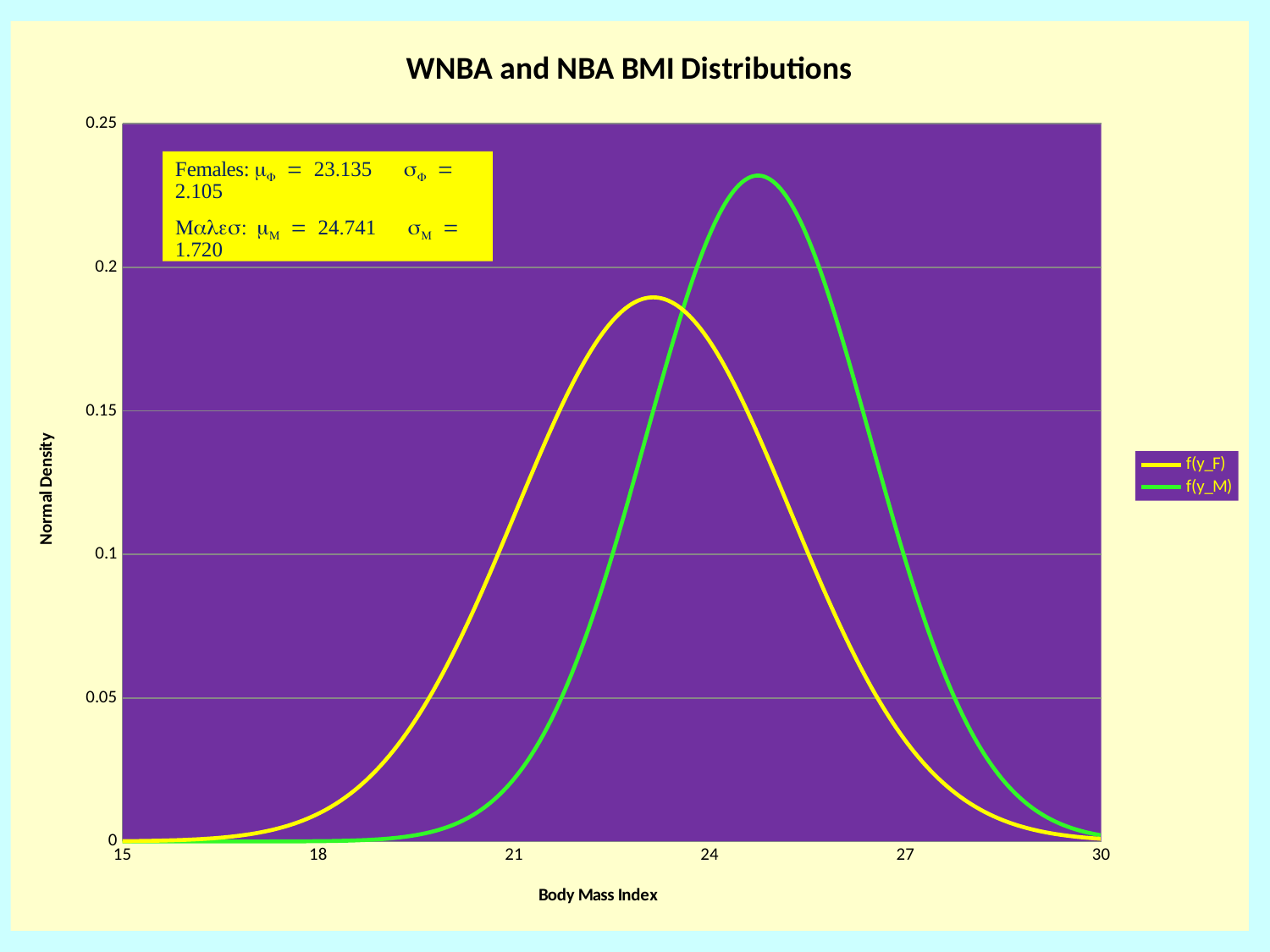
Does the f(y_F) curve rise or fall as Body Mass Index increases from 18 to 21? rise What are the two series named in the legend? f(y_F) and f(y_M) Is the peak value of f(y_M) greater or less than 0.2? greater Does the f(y_M) curve rise or fall as Body Mass Index increases from 27 to 30? fall Which series reaches the higher peak, f(y_F) or f(y_M)? f(y_M) Is the value of f(y_F) at a Body Mass Index of 21 greater or less than 0.1? greater What kind of chart is shown on the slide? line chart Is the value of f(y_F) at a Body Mass Index of 27 greater or less than 0.05? less What is the title of the chart? WNBA and NBA BMI Distributions How many series does the legend list? 2